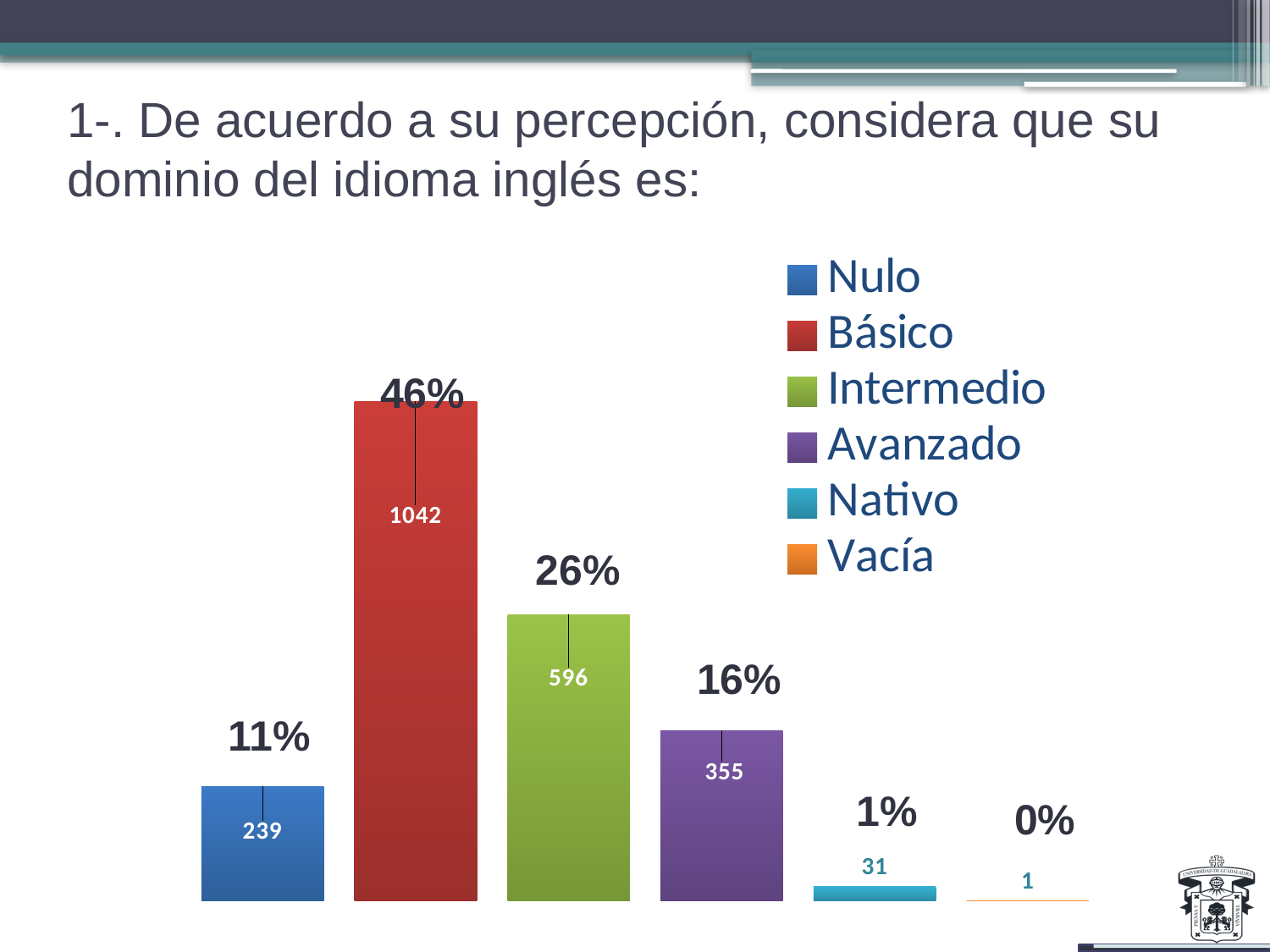
What percentage is shown for Intermedio? 26% Which legend entry is shown in red? Básico What percentage is shown for Nativo? 1% What kind of chart is shown on the slide? bar chart What is the count value shown for Básico? 1042 How many entries does the legend list? 6 What is the count value shown for Avanzado? 355 What is the difference in percentage points between Nulo and Avanzado? 5% Which category has the highest value? Básico Which category has the lowest value? Vacía What is the difference between the counts for Básico and Intermedio? 446 Which is larger, the value for Nulo or the value for Avanzado? Avanzado